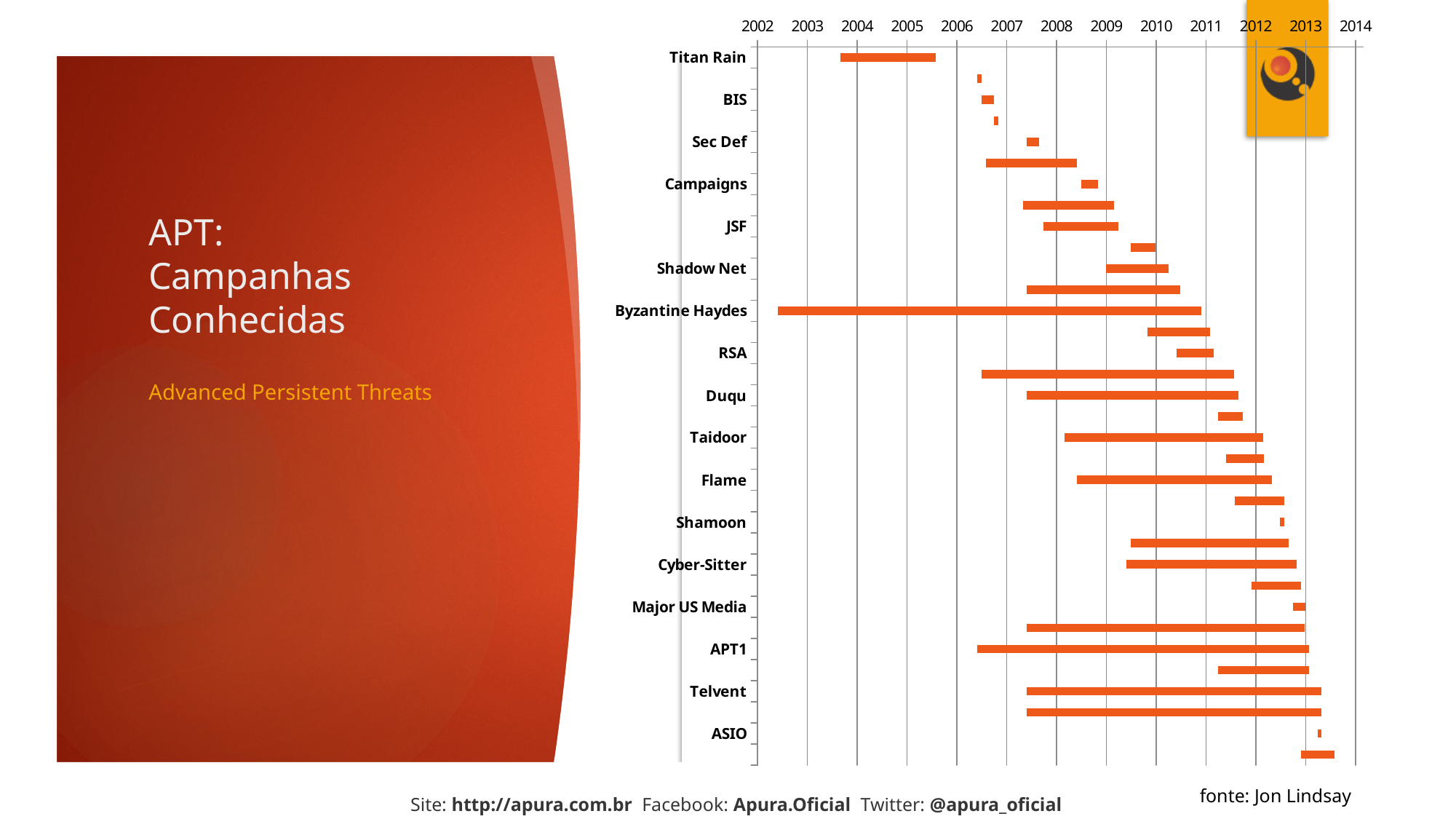
Which labelled campaign's bar starts earliest on the timeline? Byzantine Haydes Which bar is longer, Duqu or RSA? Duqu Does the Titan Rain bar start before or after 2006? before Does the Shamoon bar lie before or after 2012? after What is the title of the slide containing the chart? APT: Campanhas Conhecidas Which labelled campaign has the longest bar on the chart? Byzantine Haydes What kind of chart is shown on the slide? Bar chart (horizontal timeline) Which bar starts earlier, Titan Rain or Duqu? Titan Rain Does the Byzantine Haydes bar start before or after 2003? before What is the first year shown on the chart's horizontal axis? 2002 What is the last year shown on the chart's horizontal axis? 2014 How many campaign names are labelled on the vertical axis of the chart? 17